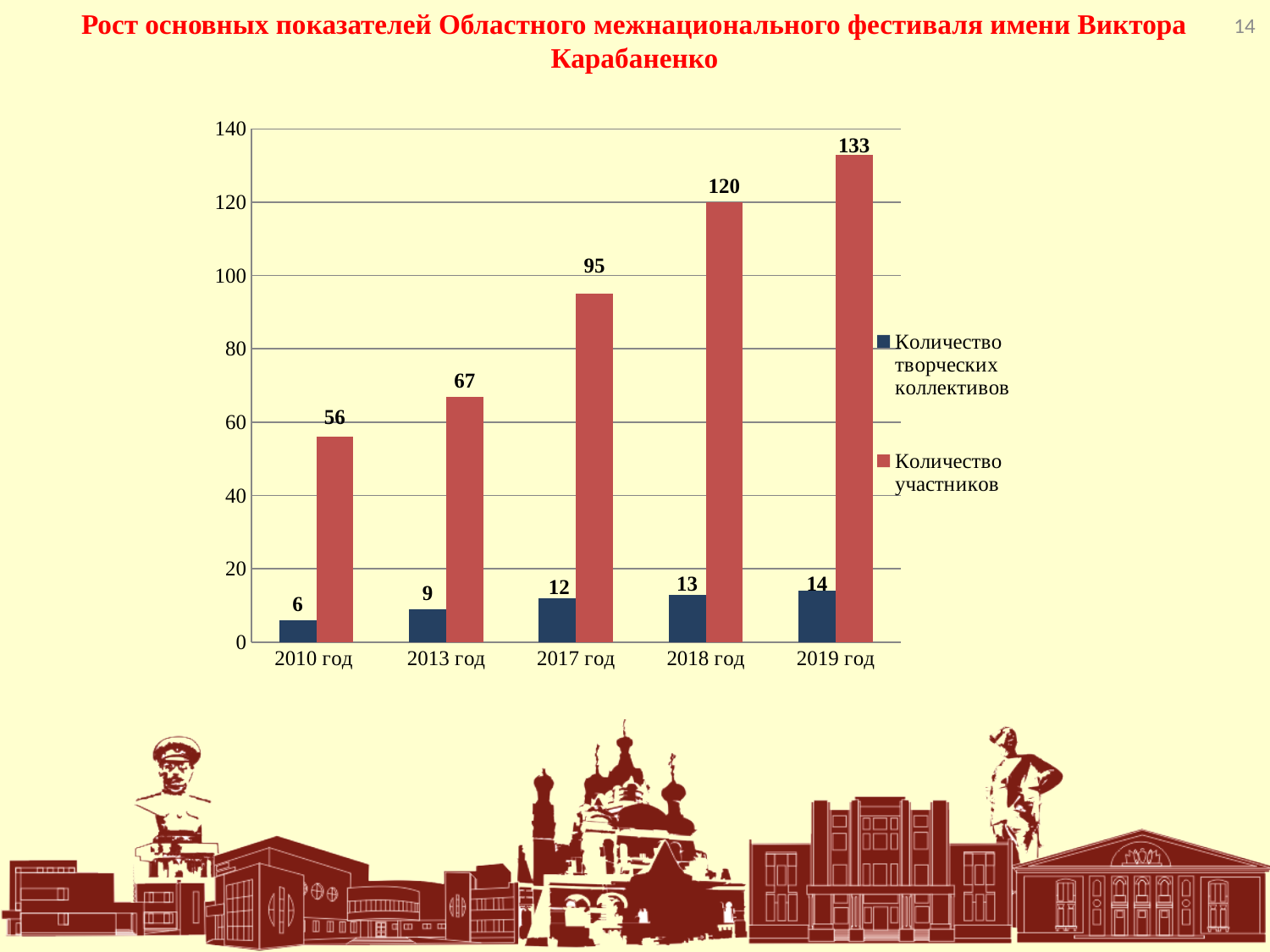
How many series does the legend list? 2 What kind of chart is shown on the slide? bar chart How many years are shown on the x axis? 5 What is the number of creative groups (Количество творческих коллективов) in 2013 год? 9 What is the number of participants (Количество участников) in 2019 год? 133 Which year has the highest number of participants (Количество участников)? 2019 год Which is larger: the number of participants in 2018 год or in 2017 год? 2018 год What is the difference in the number of participants (Количество участников) between 2019 год and 2010 год? 77 Which year has the lowest number of creative groups (Количество творческих коллективов)? 2010 год Do the values for Количество участников rise or fall from 2010 год to 2019 год? rise Is the number of participants (Количество участников) in 2013 год greater or less than 60? greater What is the number of participants (Количество участников) in 2017 год? 95